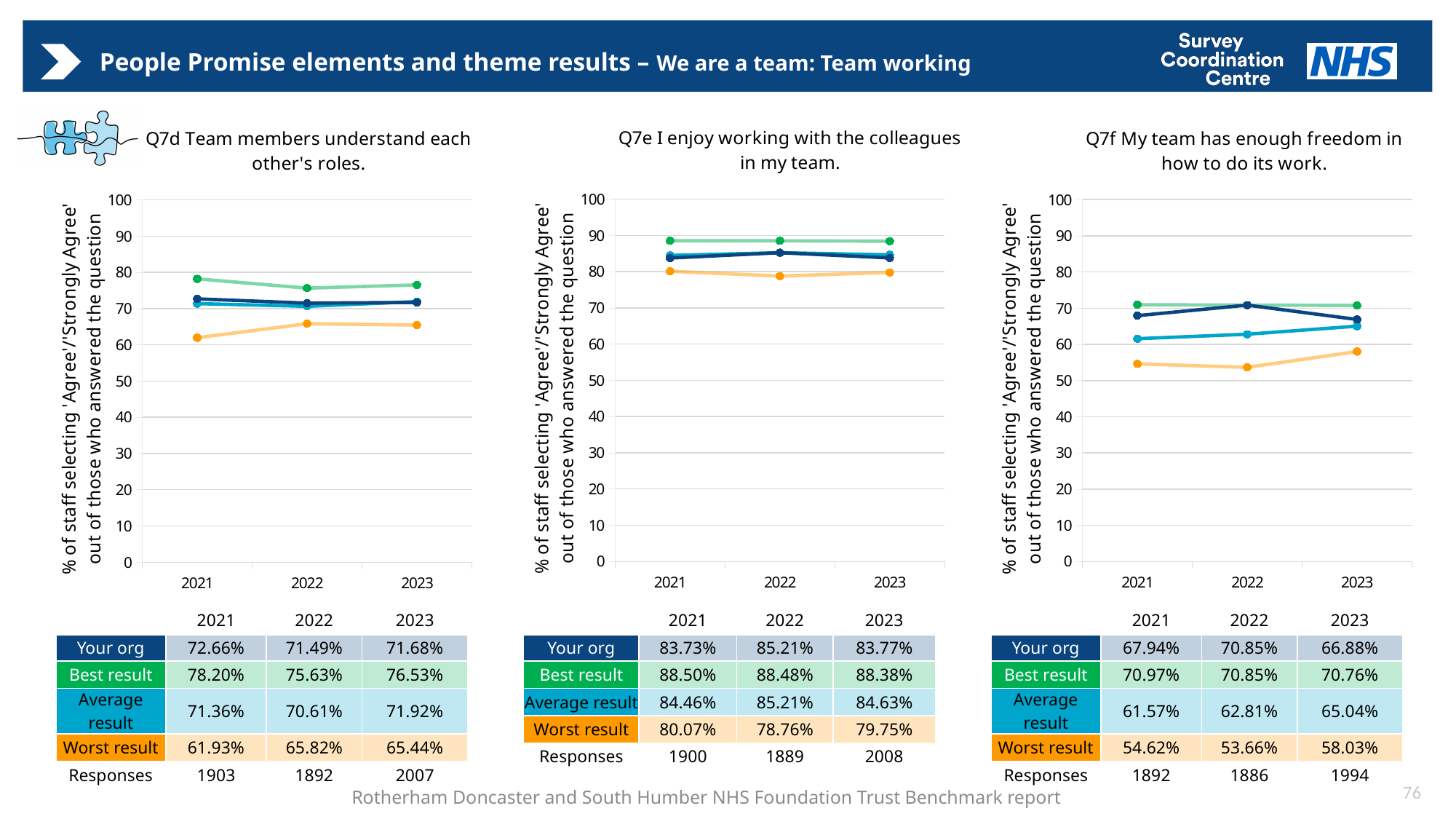
In the Q7e 'I enjoy working with the colleagues in my team' chart, what was the Worst result in 2022? 78.76% In the Q7f 'My team has enough freedom in how to do its work' chart, does the Average result rise or fall from 2021 to 2023? Rise In the Q7f 'My team has enough freedom in how to do its work' chart, which was higher in 2022: Your org or the Average result? Your org In the Q7d 'Team members understand each other's roles' chart, what is the difference between the Best result and Your org in 2021? 5.54 percentage points In the Q7e 'I enjoy working with the colleagues in my team' chart, is the Best result for 2021 greater or less than 80? greater What type of chart is used for the Q7e 'I enjoy working with the colleagues in my team' results? Line chart In the Q7d 'Team members understand each other's roles' chart, what was the Your org value in 2023? 71.68% In the Q7f 'My team has enough freedom in how to do its work' chart, in which year was the Worst result highest? 2023 In the Q7d 'Team members understand each other's roles' chart, how many responses were recorded in 2023? 2007 In the Q7d 'Team members understand each other's roles' chart, in which year was the Worst result lowest? 2021 In the Q7f 'My team has enough freedom in how to do its work' chart, by how much did Your org fall from 2022 to 2023? 3.97 percentage points In the Q7f 'My team has enough freedom in how to do its work' chart, what was the Average result in 2021? 61.57%